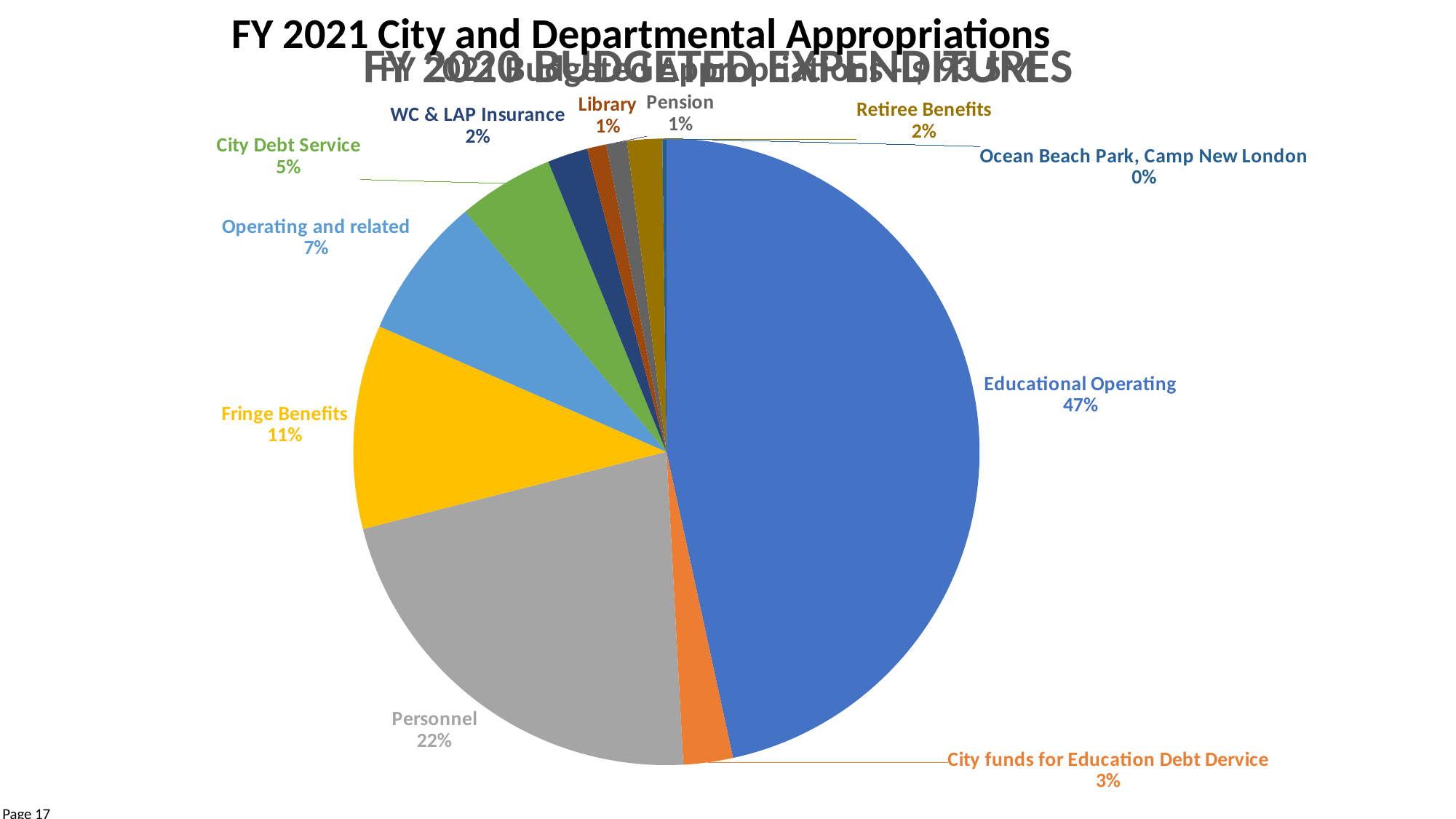
What is the value shown for Personnel? 22% What is the value shown for Fringe Benefits? 11% What is the title at the top of the slide? FY 2021 City and Departmental Appropriations What is the value shown for City funds for Education Debt Device? 3% What kind of chart is shown on the slide? Pie chart Which category has the largest slice of the pie? Educational Operating How many categories are shown in the pie chart? 11 Which is larger, Operating and related or Fringe Benefits? Fringe Benefits Which category has the smallest slice of the pie? Ocean Beach Park, Camp New London What is the value shown for City Debt Service? 5% What is the difference between the Educational Operating share and the Personnel share? 25% What share of the pie does Educational Operating represent? 47%